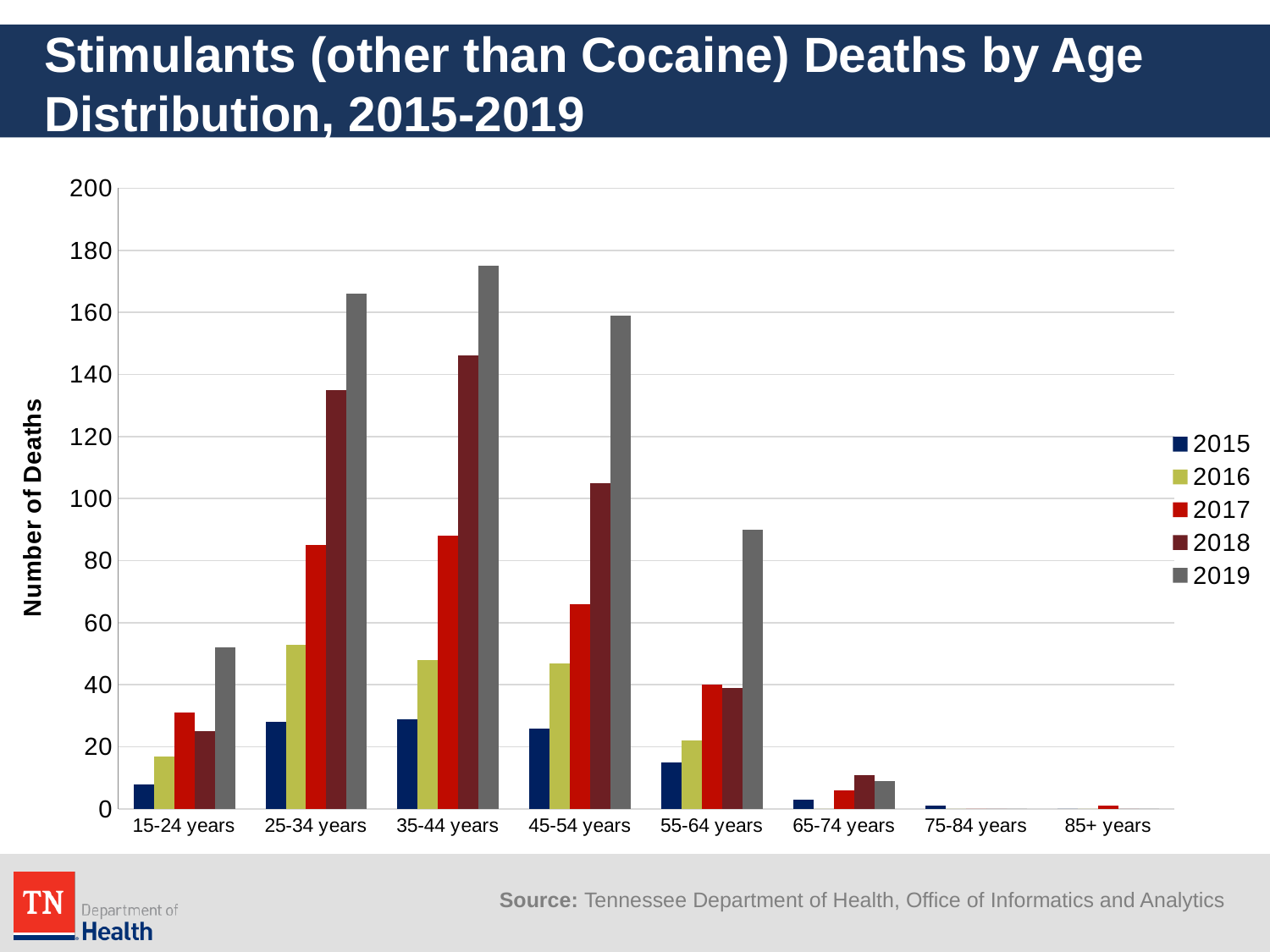
Which age group has the highest number of deaths for 2019? 35-44 years How many age groups are shown on the x axis? 8 Is the 2019 value for 35-44 years greater or less than 160? greater Is the 2015 value for 25-34 years greater or less than 40? less What is the title of the y axis? Number of Deaths For 35-44 years, do the values rise or fall from 2015 to 2019? rise For 45-54 years, which is larger: the 2018 value or the 2019 value? 2019 Is the 2019 value for 55-64 years greater or less than 80? greater What kind of chart is shown on the slide? bar chart How many series does the legend list? 5 Which age group has the highest number of deaths for 2018? 35-44 years